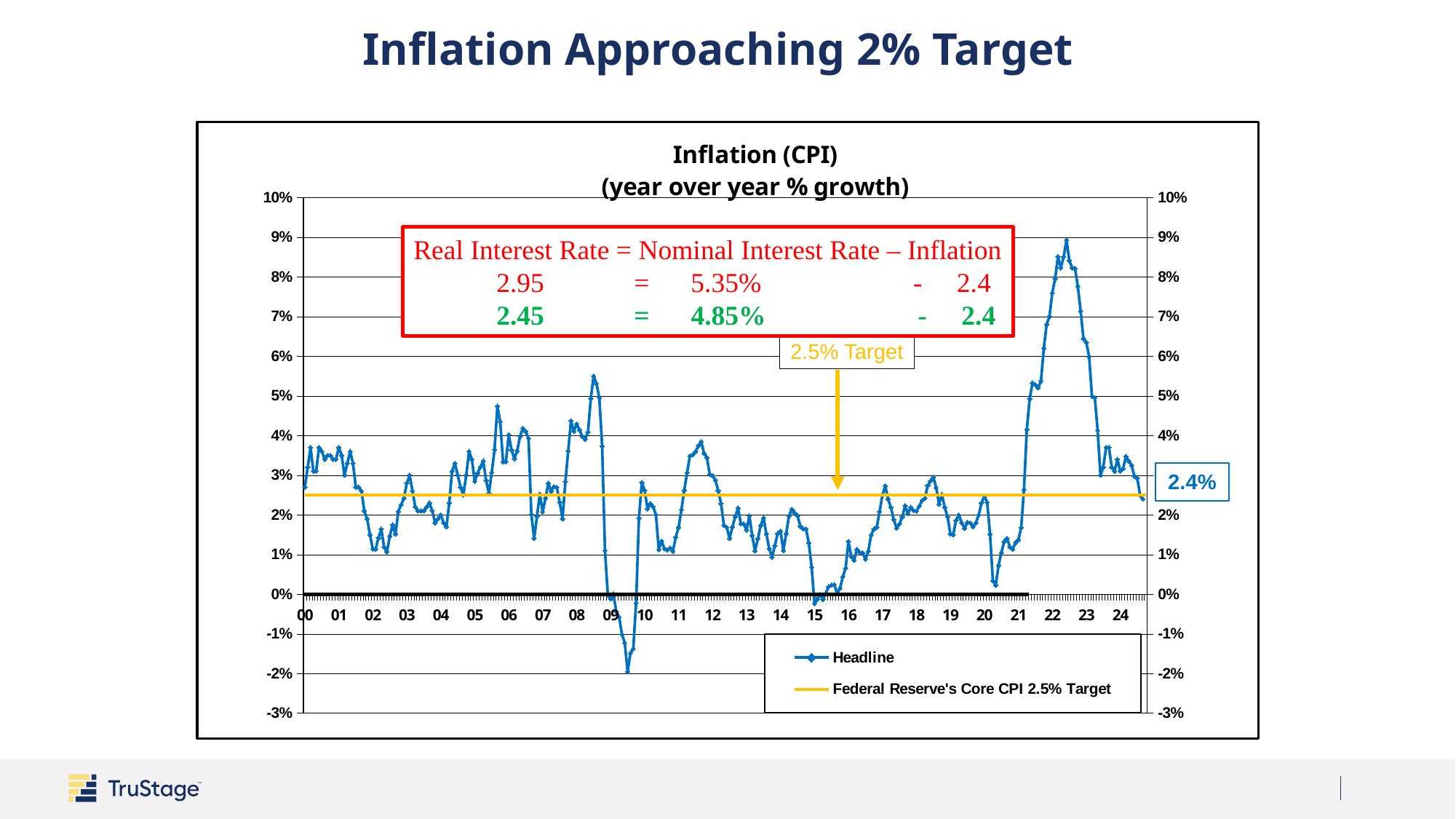
In which year does the Headline inflation line reach its highest point? 22 Which is higher: the Headline inflation peak in 2008 or the peak in 2022? 2022 What is the most recent Headline inflation value labeled at the right end of the line? 2.4% What is the legend label for the yellow line? Federal Reserve's Core CPI 2.5% Target In which year does the Headline inflation line reach its lowest point? 09 What type of chart is shown on the slide? line chart Is the peak Headline inflation value around 2022 greater or less than 8%? greater At what level is the yellow Federal Reserve's Core CPI target line drawn? 2.5% How many series does the chart's legend list? 2 Is the Headline inflation value around 2015 greater or less than 1%? less Does the Headline inflation line rise or fall from its 2022 peak to the end of 2024? fall Is the lowest Headline inflation value around 2009 greater or less than -1%? less